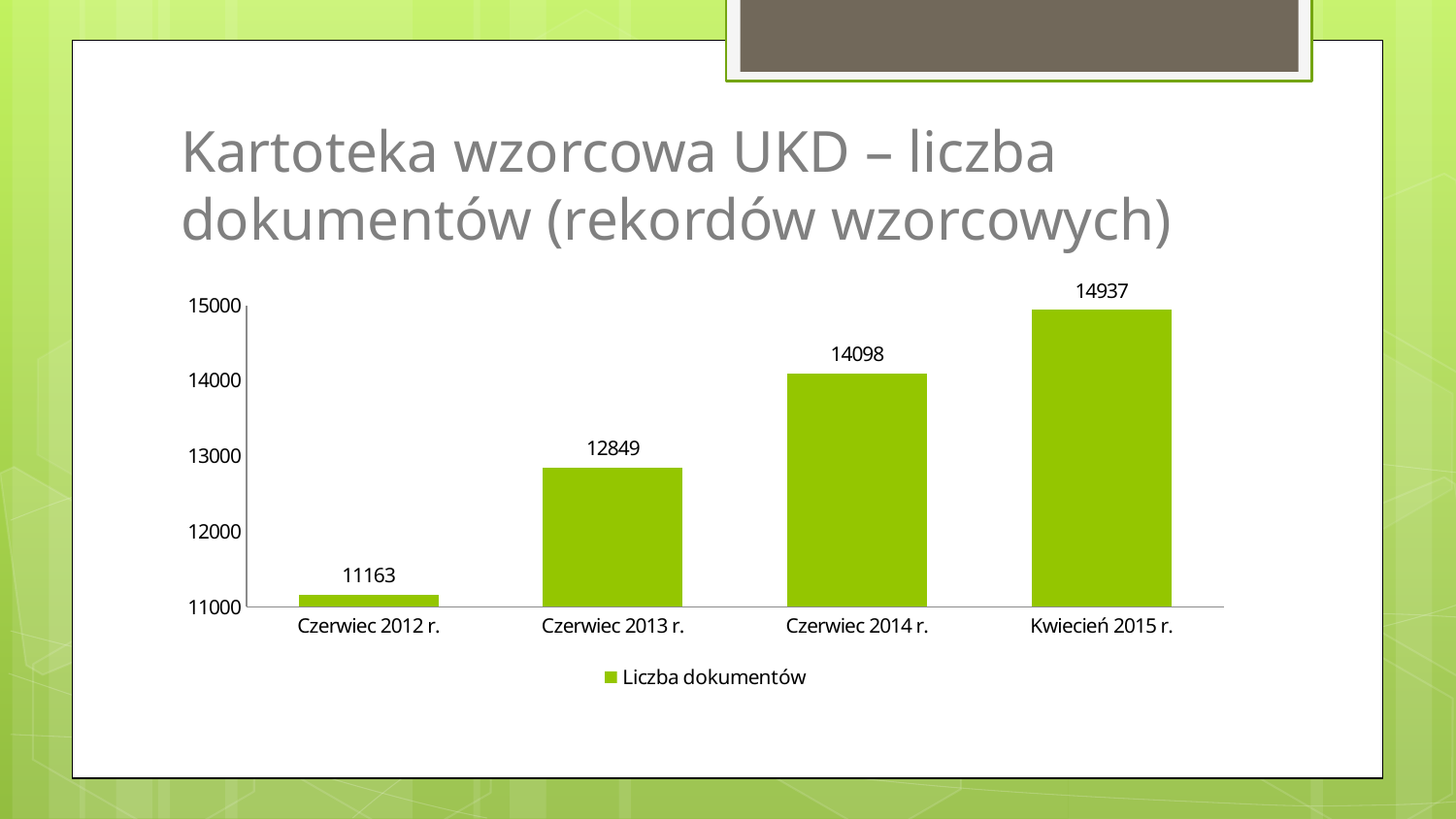
What kind of chart is shown on the slide? Bar chart What is the value for Czerwiec 2012 r.? 11163 Which category has the lowest value? Czerwiec 2012 r. What is the difference between the values for Czerwiec 2014 r. and Czerwiec 2013 r.? 1249 Do the values rise or fall from Czerwiec 2012 r. to Kwiecień 2015 r.? Rise How many categories are shown on the x axis? 4 What is the value for Czerwiec 2013 r.? 12849 Which category has the highest value? Kwiecień 2015 r. Which is larger, the value for Czerwiec 2013 r. or Czerwiec 2014 r.? Czerwiec 2014 r. What is the value for Czerwiec 2014 r.? 14098 What is the difference between the values for Kwiecień 2015 r. and Czerwiec 2012 r.? 3774 What is the value for Kwiecień 2015 r.? 14937